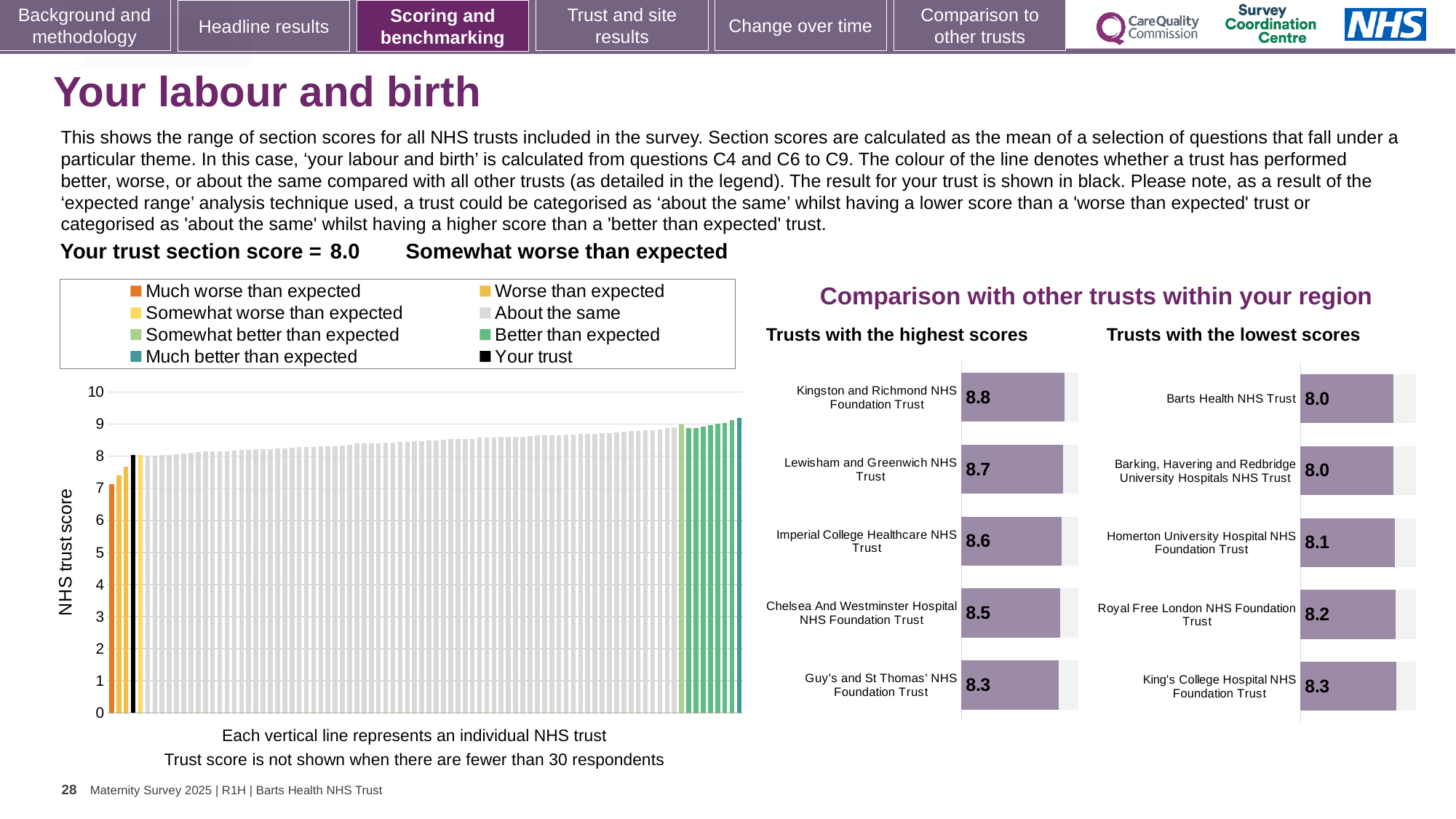
In the 'Trusts with the lowest scores' chart, which has the larger score: Royal Free London NHS Foundation Trust or Homerton University Hospital NHS Foundation Trust? Royal Free London NHS Foundation Trust In the 'Trusts with the highest scores' chart, what is the difference between the scores of Kingston and Richmond NHS Foundation Trust and Guy's and St Thomas' NHS Foundation Trust? 0.5 In the chart on the left showing the range of section scores, what kind of chart is it? Bar chart In the chart on the left showing the range of section scores, how many entries does the legend list? 8 In the chart on the left showing the range of section scores, do the values rise or fall from left to right along the x axis? Rise In the 'Trusts with the lowest scores' chart, what is the difference between the scores of King's College Hospital NHS Foundation Trust and Royal Free London NHS Foundation Trust? 0.1 In the 'Trusts with the lowest scores' chart, what is the score for Homerton University Hospital NHS Foundation Trust? 8.1 In the 'Trusts with the highest scores' chart, what is the score for Imperial College Healthcare NHS Trust? 8.6 In the 'Trusts with the lowest scores' chart, which trust has the highest score? King's College Hospital NHS Foundation Trust In the 'Trusts with the highest scores' chart, which trust has the lowest score? Guy's and St Thomas' NHS Foundation Trust In the 'Trusts with the highest scores' chart, how many trusts are shown? 5 In the 'Trusts with the highest scores' chart, what is the score for Kingston and Richmond NHS Foundation Trust? 8.8